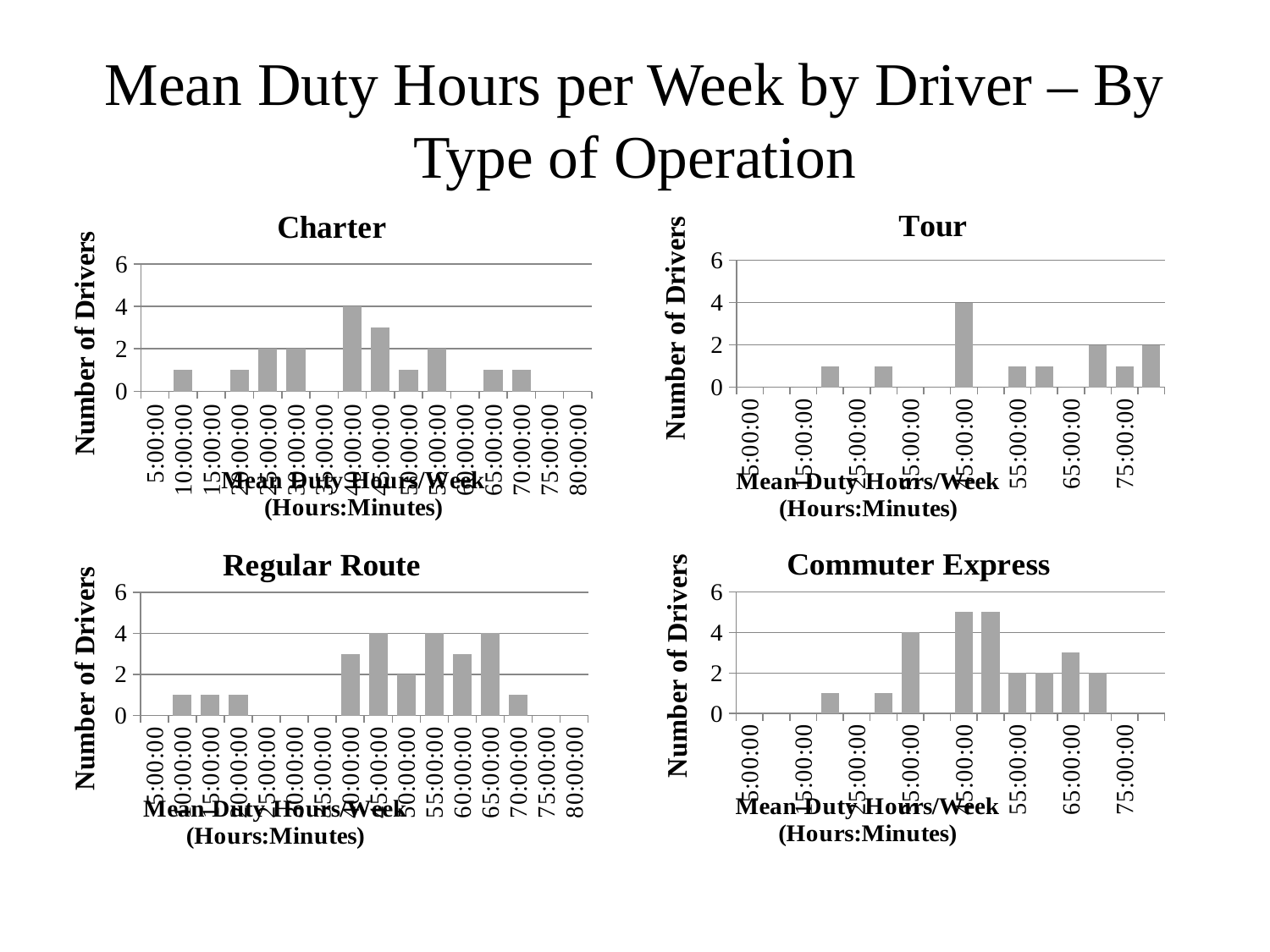
In the Charter chart, how many drivers are in the 40:00:00 category? 4 In the Regular Route chart, how many drivers are in the 50:00:00 category? 2 In the Tour chart, how many drivers are in the 45:00:00 category? 4 In the Tour chart, is the number of drivers for 75:00:00 greater or less than 2? less In the Charter chart, what is the difference in number of drivers between the 40:00:00 and 25:00:00 categories? 2 In the Tour chart, which mean duty hours category has the highest number of drivers? 45:00:00 In the Charter chart, how many drivers are in the 25:00:00 category? 2 In the Commuter Express chart, how many drivers are in the 35:00:00 category? 4 How many charts are shown on the slide? 4 In the Commuter Express chart, is the number of drivers for 45:00:00 greater or less than 4? greater What kind of chart is the Charter chart? bar chart In the Charter chart, which mean duty hours category has the highest number of drivers? 40:00:00